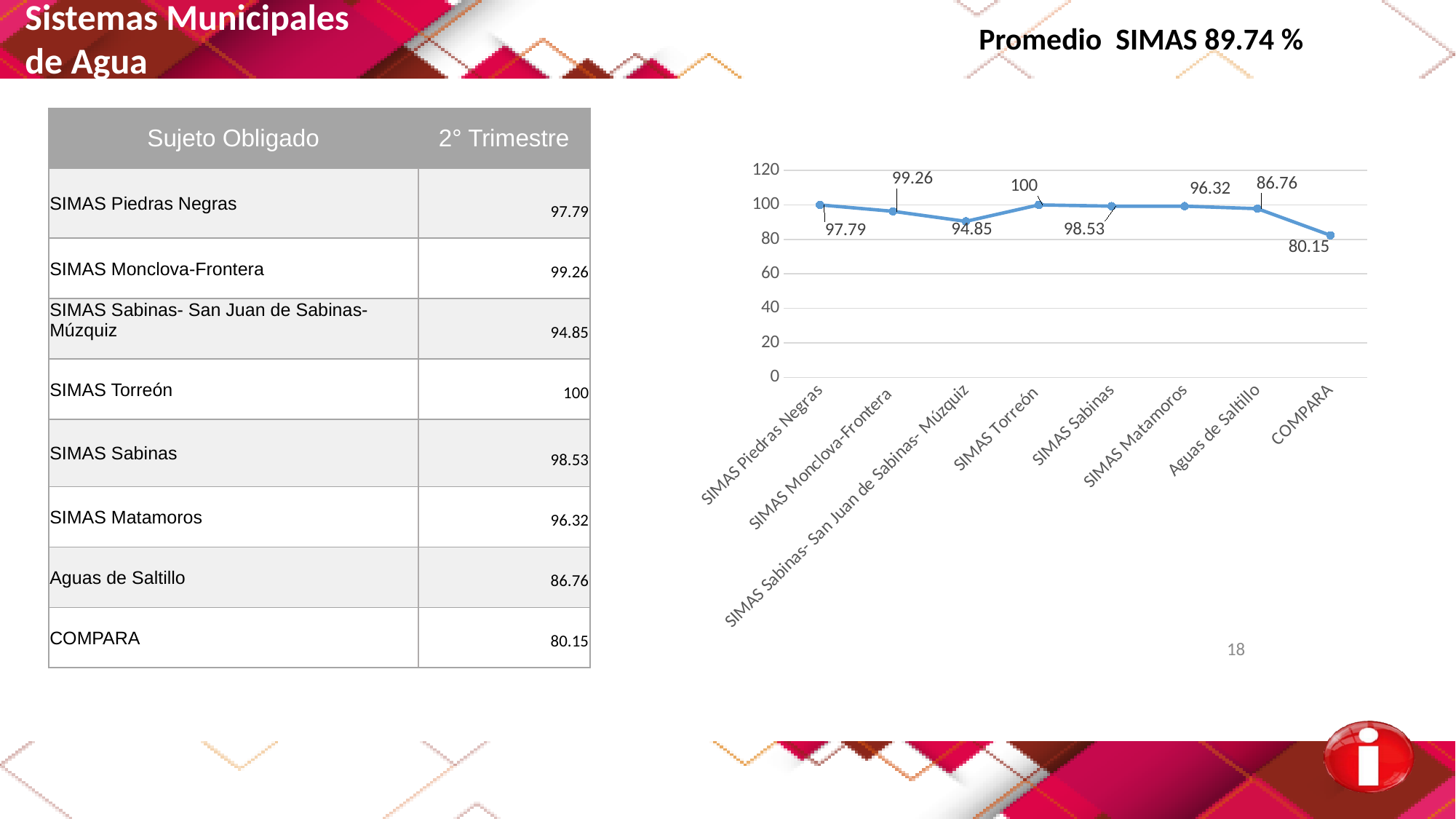
How many categories are plotted on the x axis of the chart? 8 Is the value for SIMAS Piedras Negras greater or less than 80? greater What is the difference between the values for SIMAS Torreón and COMPARA? 19.85 What is the value for COMPARA in the chart? 80.15 What is the difference between the values for SIMAS Monclova-Frontera and Aguas de Saltillo? 12.5 What is the value for SIMAS Sabinas- San Juan de Sabinas- Múzquiz in the chart? 94.85 What type of chart is shown on the slide? line chart What is the highest tick value shown on the y axis of the chart? 120 What is the value for SIMAS Torreón in the chart? 100 Which is larger, the value for SIMAS Matamoros or the value for Aguas de Saltillo? SIMAS Matamoros Which category has the lowest value in the chart? COMPARA Which category has the highest value in the chart? SIMAS Torreón